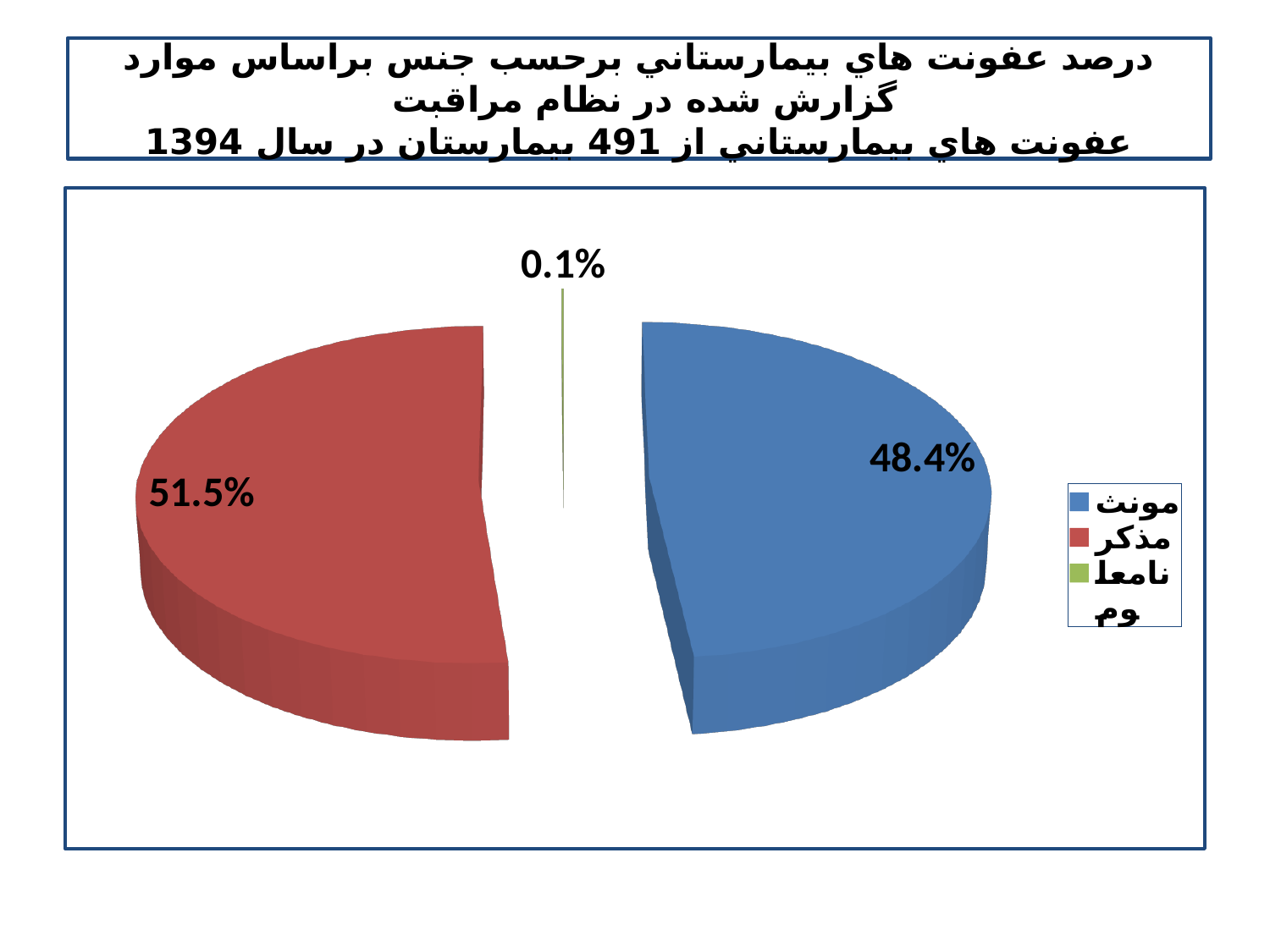
Which category has the largest share of the pie? مذکر How many slices does the pie chart have? 3 What percentage of the pie is labelled for the مذکر (male) slice? 51.5% Which category has the smallest share of the pie? نامعلوم What kind of chart is shown on the slide? pie chart What percentage of the pie is labelled for the نامعلوم (unknown) slice? 0.1% What colour is the slice representing مذکر? red What is the difference in percentage points between the مذکر slice and the مونث slice? 3.1 Which is larger, the share for مذکر or the share for مونث? مذکر What colour is the slice representing مونث? blue What percentage of the pie is labelled for the مونث (female) slice? 48.4% How many entries does the legend list? 3